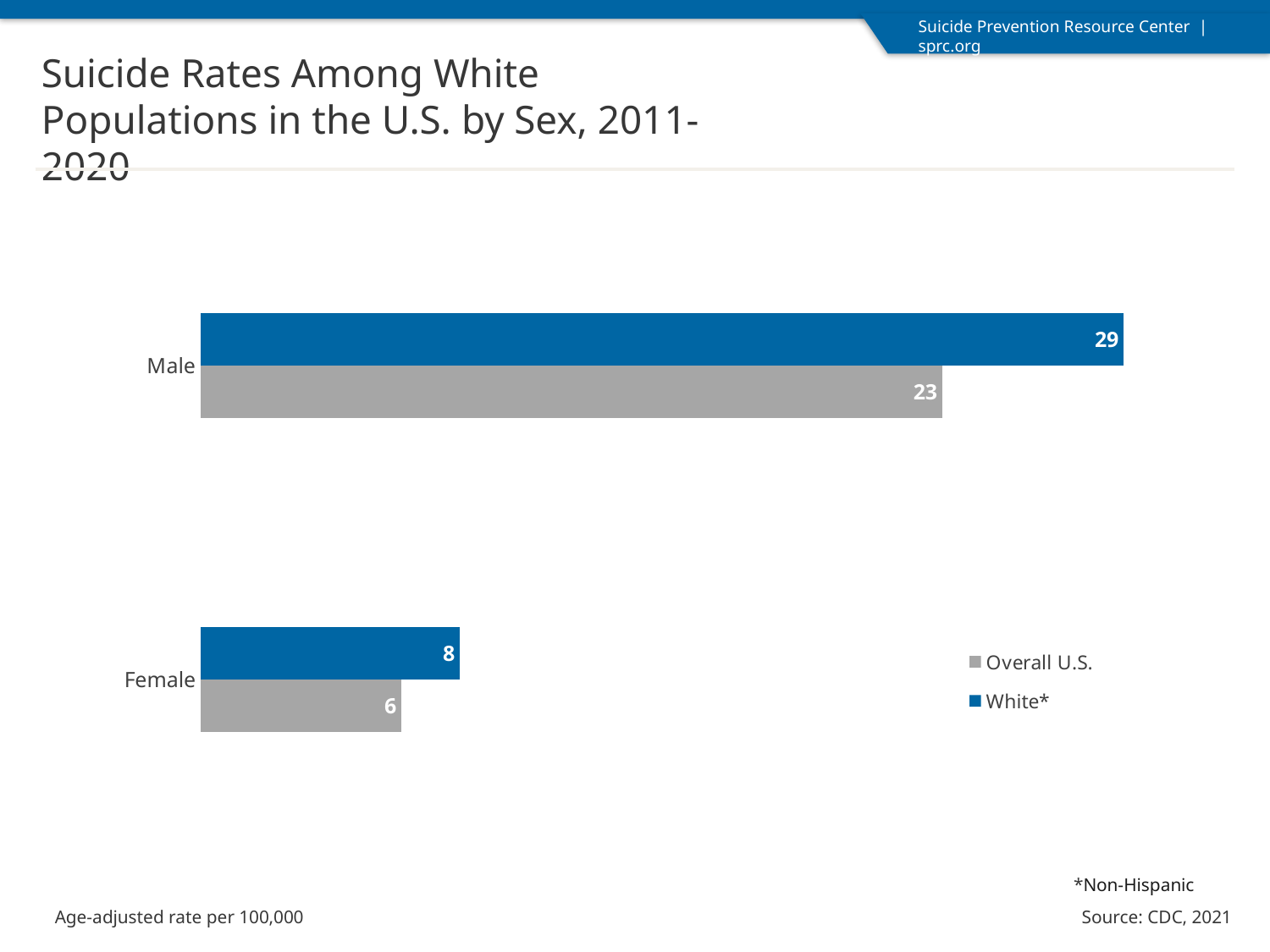
How many categories are shown on the chart? 2 How many series does the legend list? 2 What is the difference between the White* and Overall U.S. rates for females? 2 What kind of chart is shown on the slide? Bar chart What is the difference between the White* and Overall U.S. rates for males? 6 Which category has the lowest value in the Overall U.S. series? Female What is the Overall U.S. suicide rate for males? 23 Which category has the highest value in the White* series? Male What is the suicide rate for White* females? 8 What is the suicide rate for White* males? 29 What is the Overall U.S. suicide rate for females? 6 Which is larger, the White* rate for females or the Overall U.S. rate for females? White*